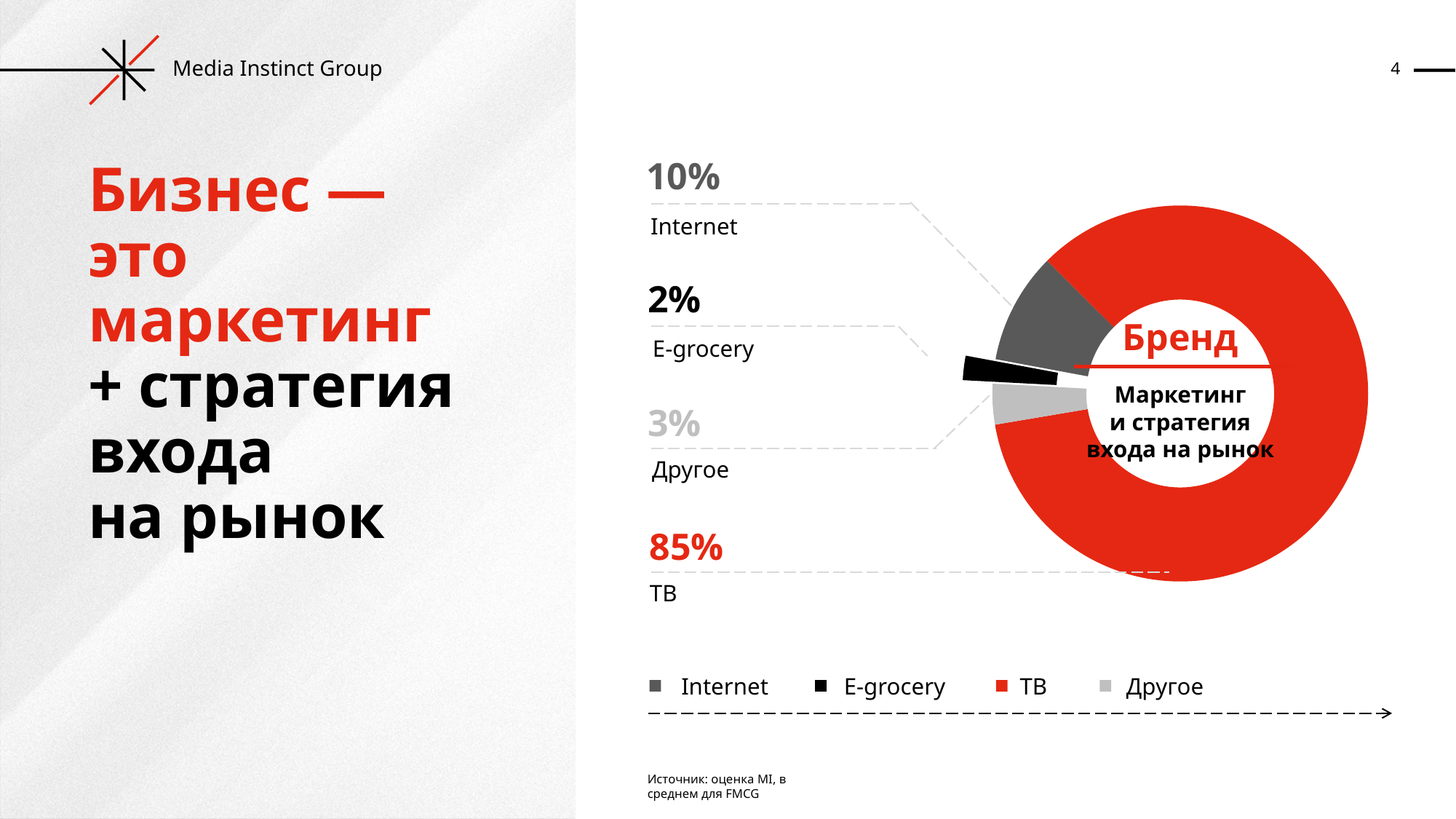
What colour is used for the ТВ segment in the chart? Red Which category has the largest share of the chart? ТВ What is the value shown for Другое? 3% What share of the chart does TV (ТВ) account for? 85% Which category has the smallest share of the chart? E-grocery Which is larger, the share for Internet or the share for Другое? Internet What is the difference between the shares of ТВ and Internet? 75% How many entries does the legend list? 4 How many categories does the chart show? 4 What is the value shown for E-grocery? 2% What is the value shown for Internet? 10% What kind of chart is shown on the slide? Pie chart (doughnut)